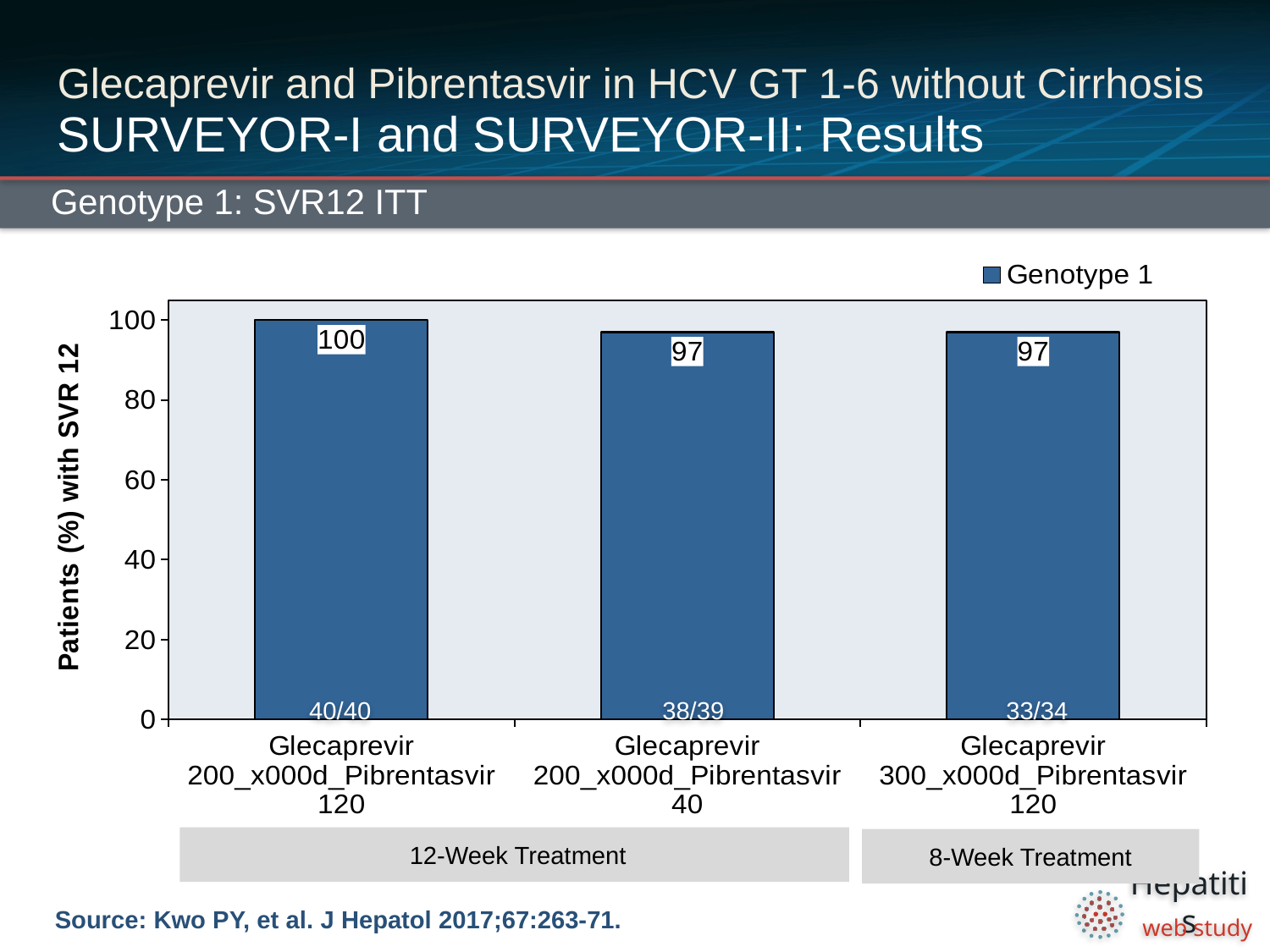
What is the SVR12 value for Glecaprevir 300 / Pibrentasvir 120 in the 8-week treatment group? 97 Which is larger: the SVR12 value for Glecaprevir 200 / Pibrentasvir 120 or for Glecaprevir 300 / Pibrentasvir 120? Glecaprevir 200 / Pibrentasvir 120 What patient fraction is shown at the base of the bar for Glecaprevir 200 / Pibrentasvir 40? 38/39 What is the SVR12 value for Glecaprevir 200 / Pibrentasvir 40 in the 12-week treatment group? 97 How many treatment arms (bars) are shown in the chart? 3 What patient fraction is shown at the base of the bar for Glecaprevir 300 / Pibrentasvir 120 (8-week treatment)? 33/34 What is the SVR12 value for Glecaprevir 200 / Pibrentasvir 120 in the 12-week treatment group? 100 Which treatment arm has the highest SVR12 value? Glecaprevir 200 / Pibrentasvir 120 (12-week treatment) What is the label of the y-axis? Patients (%) with SVR 12 What kind of chart is shown on the slide? Bar chart What is the difference between the SVR12 value for Glecaprevir 200 / Pibrentasvir 120 and Glecaprevir 200 / Pibrentasvir 40? 3 How many series does the legend list? 1